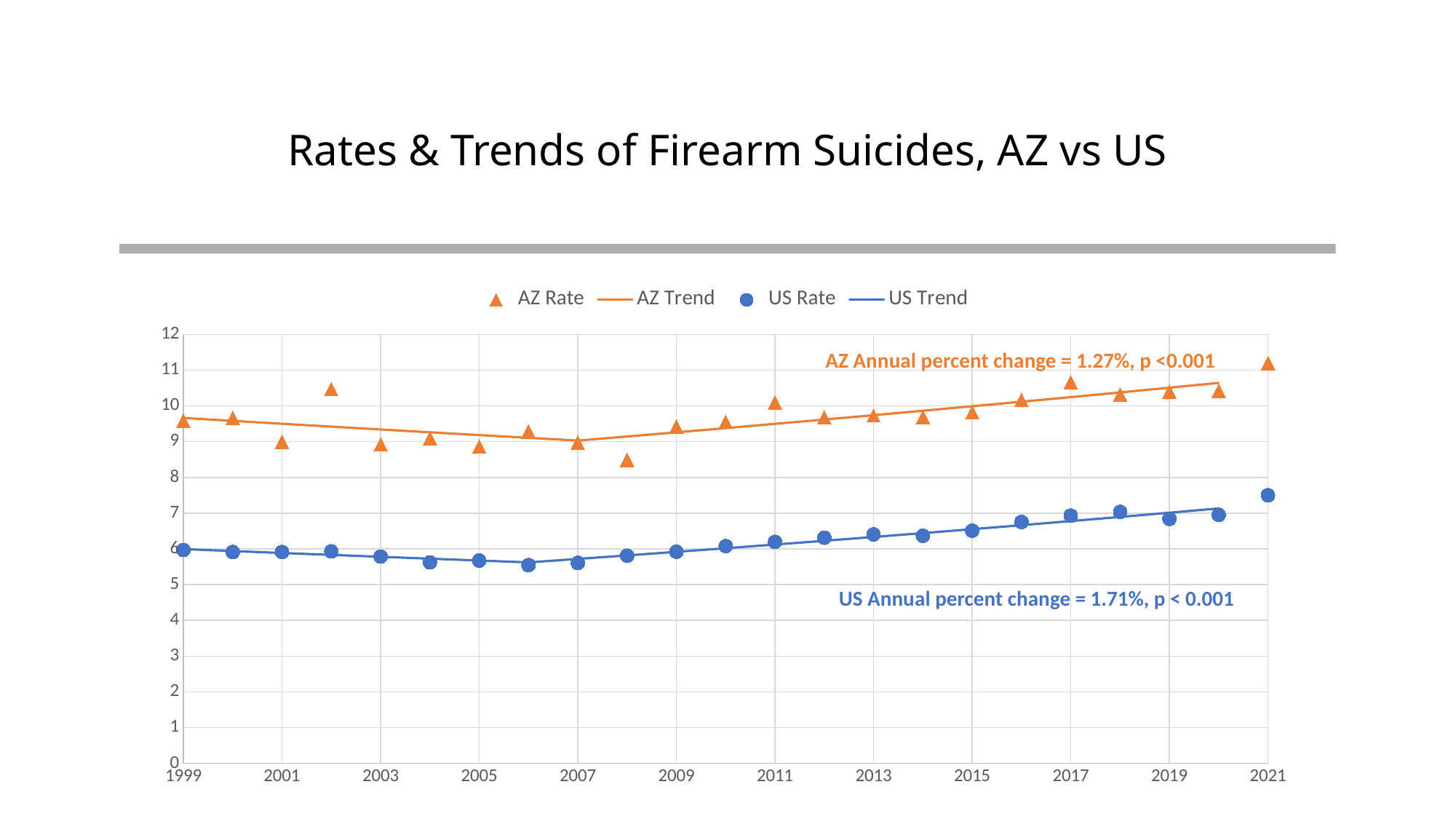
Is the US Rate for 2021 greater or less than 7? greater Which is higher in 2015, the AZ Rate or the US Rate? AZ Rate Does the US Trend line rise or fall between 2007 and 2020? rise Which has the larger annual percent change, AZ or US? US What is the title of the chart? Rates & Trends of Firearm Suicides, AZ vs US In which year is the AZ Rate at its lowest? 2008 Is the AZ Rate for 2002 greater or less than 10? greater How many series does the legend list? 4 What is the AZ annual percent change shown on the chart? 1.27% Is the US Rate for 2007 greater or less than 6? less What is the US annual percent change shown on the chart? 1.71% In which year is the AZ Rate at its highest? 2021